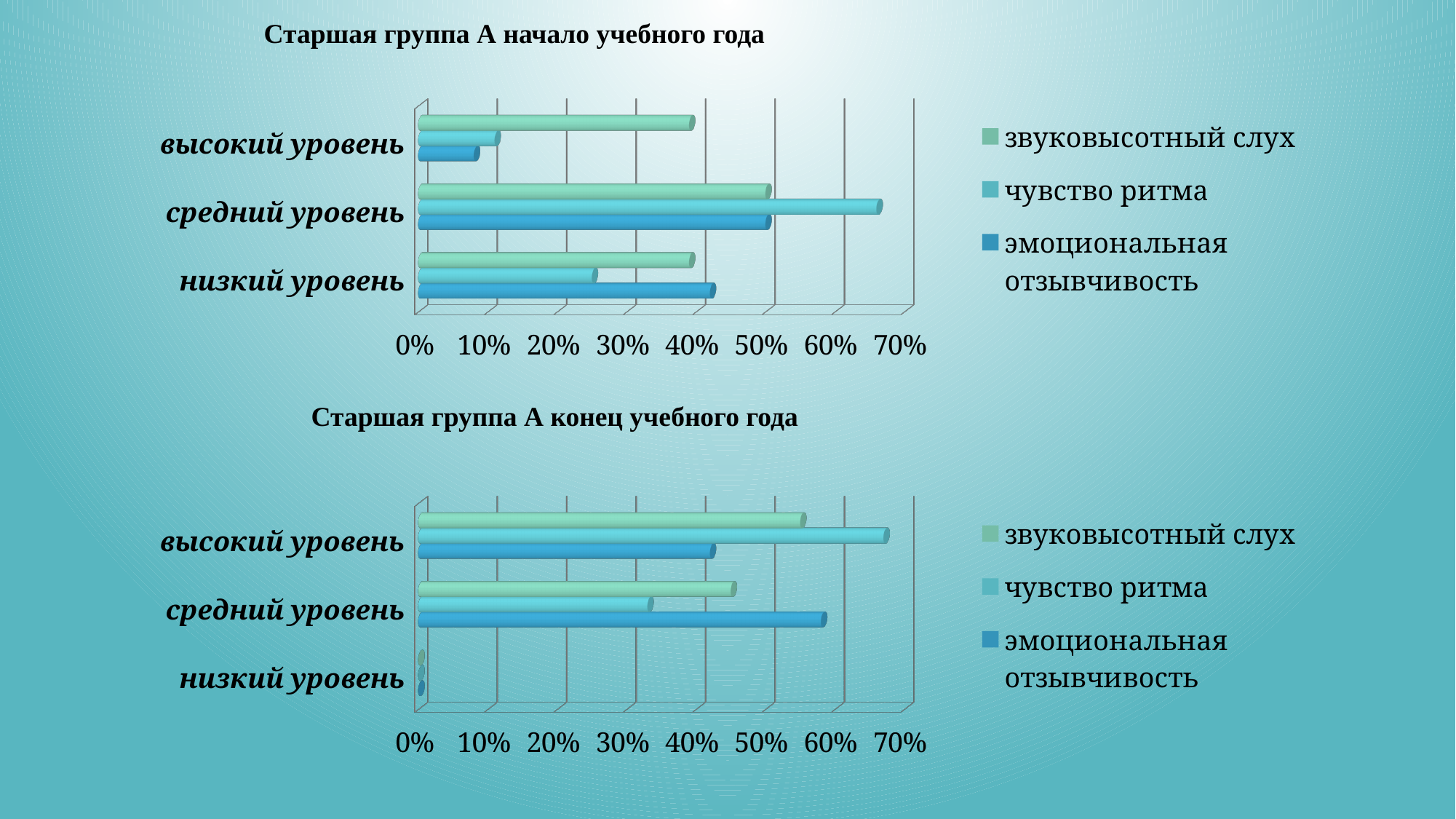
In the bottom chart, 'Старшая группа А конец учебного года', which is larger for 'высокий уровень': 'звуковысотный слух' or 'эмоциональная отзывчивость'? звуковысотный слух How many series does the legend of the bottom chart, 'Старшая группа А конец учебного года', list? 3 What kind of chart is the top chart, 'Старшая группа А начало учебного года'? bar chart In the bottom chart, 'Старшая группа А конец учебного года', is the value of 'чувство ритма' for 'высокий уровень' greater or less than 60%? greater In the bottom chart, 'Старшая группа А конец учебного года', which series has the highest value for 'средний уровень'? эмоциональная отзывчивость In the top chart, 'Старшая группа А начало учебного года', which series has the highest value for 'средний уровень'? чувство ритма In the top chart, 'Старшая группа А начало учебного года', which series has the lowest value for 'высокий уровень'? эмоциональная отзывчивость In the top chart, 'Старшая группа А начало учебного года', is the value of 'чувство ритма' for 'средний уровень' greater or less than 60%? greater How many categories are shown on the y axis of the top chart, 'Старшая группа А начало учебного года'? 3 In the top chart, 'Старшая группа А начало учебного года', is the value of 'эмоциональная отзывчивость' for 'высокий уровень' greater or less than 20%? less What is the title of the bottom chart on the slide? Старшая группа А конец учебного года In the top chart, 'Старшая группа А начало учебного года', which is larger for 'низкий уровень': 'звуковысотный слух' or 'чувство ритма'? звуковысотный слух